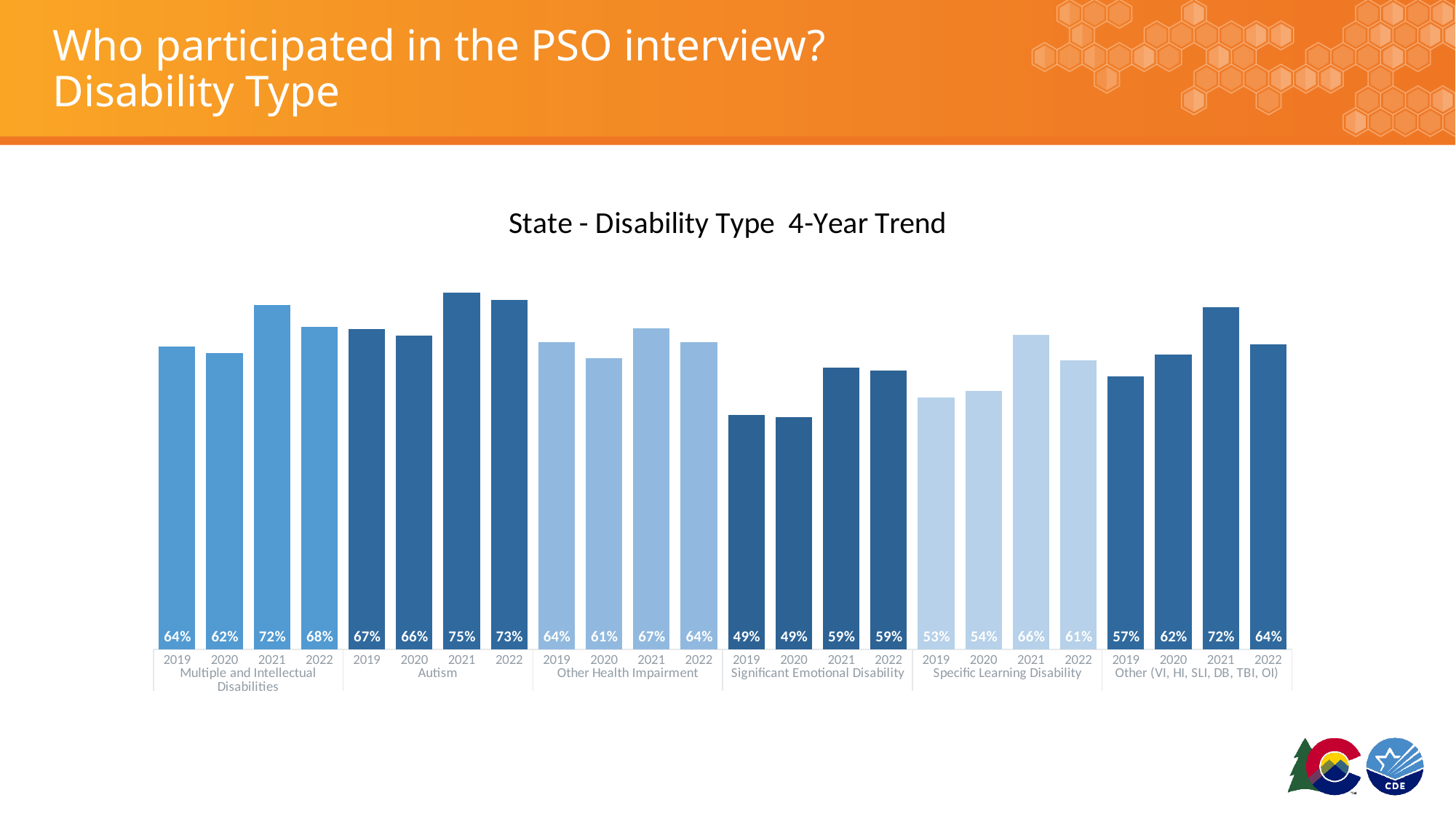
Which year has the lowest value for Multiple and Intellectual Disabilities? 2020 What is the value for Other (VI, HI, SLI, DB, TBI, OI) in 2020? 62% Which disability type and year has the highest value on the chart? Autism, 2021 What kind of chart is shown on the slide? Bar chart What is the value for Autism in 2021? 75% Which is larger: the 2022 value for Autism or the 2022 value for Other Health Impairment? Autism 2022 How many disability type groups are shown on the chart? 6 What is the difference between the 2021 and 2019 values for Specific Learning Disability? 13% What is the title of the chart? State - Disability Type 4-Year Trend What is the value for Specific Learning Disability in 2022? 61% What is the value for Significant Emotional Disability in 2019? 49% Do the values for Other (VI, HI, SLI, DB, TBI, OI) rise or fall from 2019 to 2021? Rise